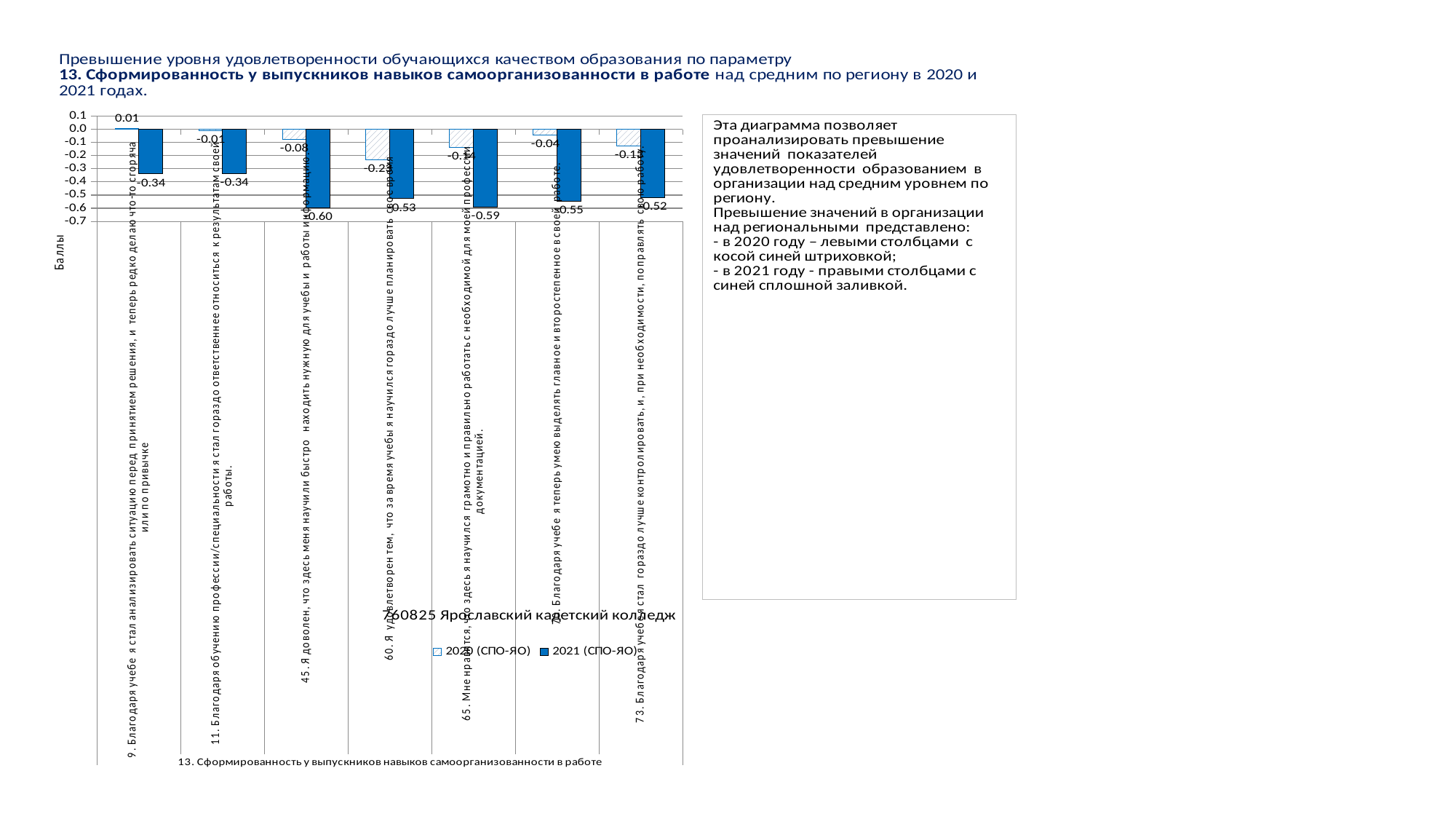
What is the title of the chart? 760825 Ярославский кадетский колледж What is the 2020 (СПО-ЯО) value for statement 9 ("Благодаря учебе я стал анализировать ситуацию перед принятием решения...")? 0.01 Which statement has the highest 2020 (СПО-ЯО) value? Statement 9 How many categories (statements) are plotted on the x axis of the chart? 7 What is the 2021 (СПО-ЯО) value for statement 11 ("Благодаря обучению профессии/специальности я стал гораздо ответственнее относиться к результатам своей работы")? -0.34 Is the 2021 (СПО-ЯО) value for statement 60 greater or less than -0.5? less Which is larger: the 2021 (СПО-ЯО) value for statement 70 or for statement 73? Statement 73 What is the 2021 (СПО-ЯО) value for statement 45 ("Я доволен, что здесь меня научили быстро находить нужную для учебы и работы информацию")? -0.60 For statement 60, what is the difference between the 2020 (СПО-ЯО) value (-0.23) and the 2021 (СПО-ЯО) value (-0.53)? 0.30 Which statement has the lowest 2021 (СПО-ЯО) value? Statement 45 How many series does the chart legend list? 2 What kind of chart is shown on the slide? bar chart